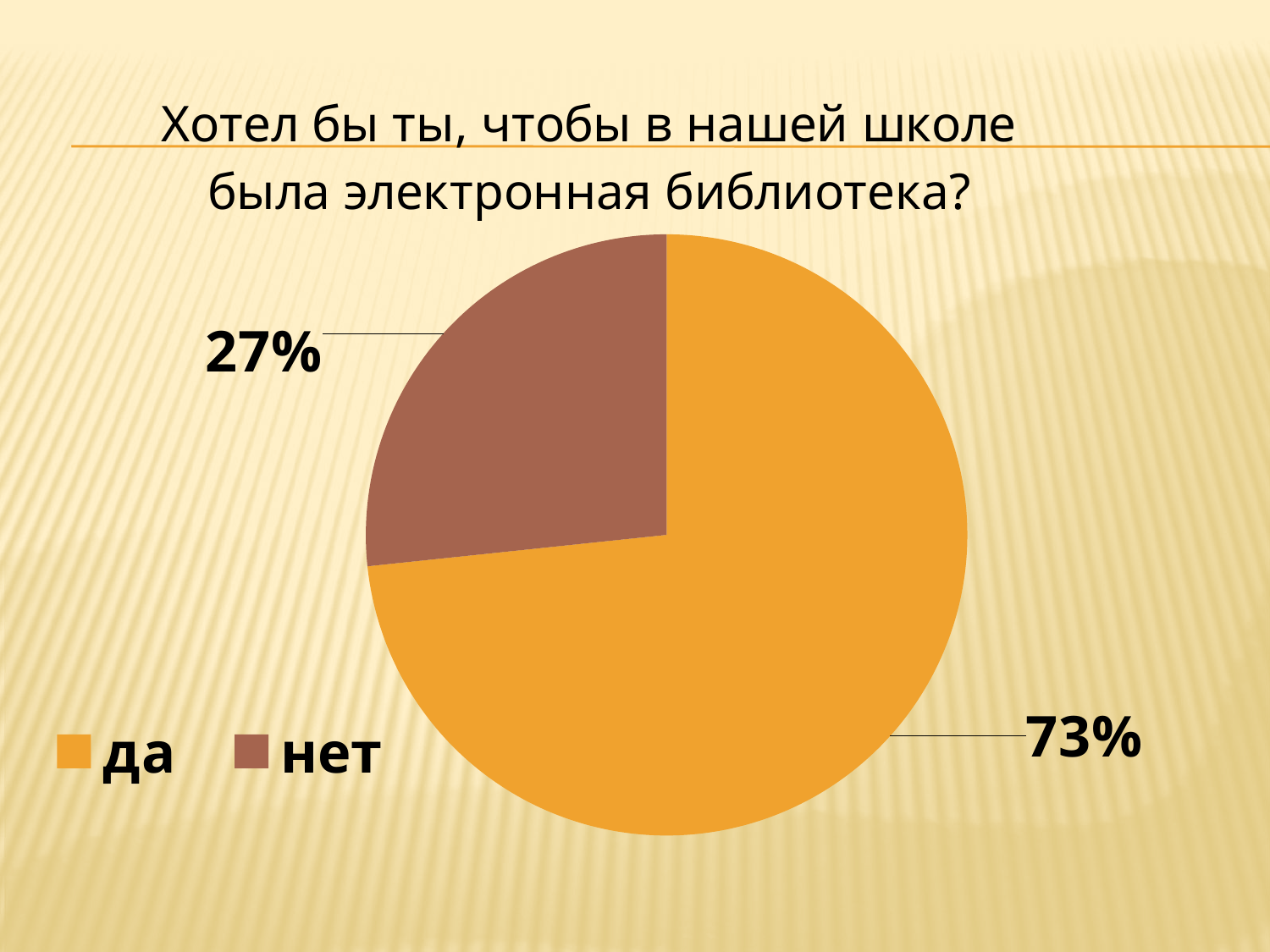
How many categories does the pie chart have? 2 What is the title of the chart? Хотел бы ты, чтобы в нашей школе была электронная библиотека? Which category has the largest slice of the pie? да What percentage of the pie is labelled for "нет"? 27% What share of the pie does the "нет" slice take? 27% What kind of chart is shown on the slide? pie chart Which category has the smallest slice of the pie? нет How many entries does the legend list? 2 What is the difference in percentage points between the "да" and "нет" slices? 46 Which slice is larger, "да" or "нет"? да What percentage of the pie is labelled for "да"? 73% What colour is the "да" slice in the pie chart? orange